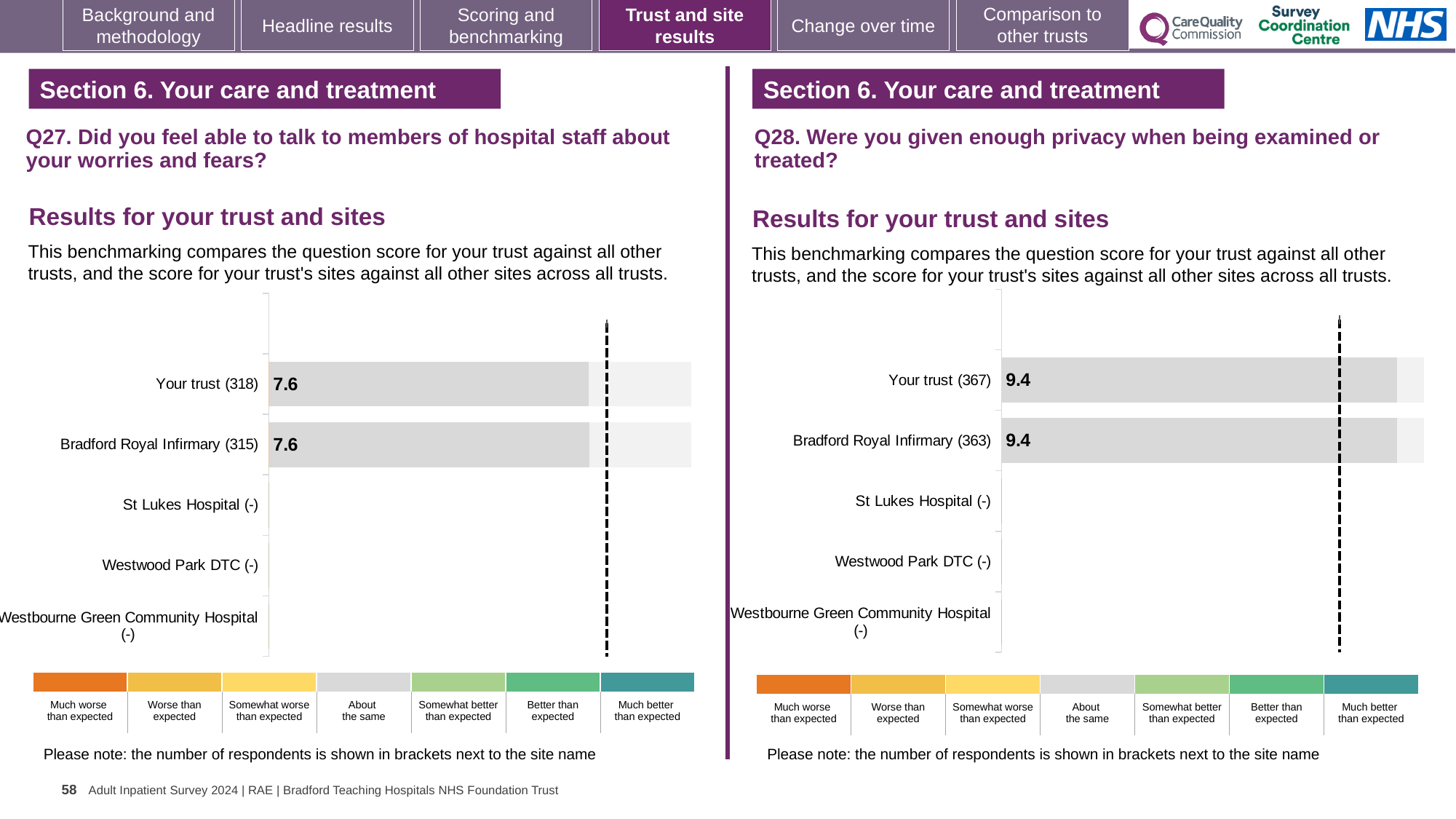
What kind of chart is the Q28 chart (right)? Bar chart How many site/trust categories are listed on the Q27 chart (left)? 5 Which is larger: the Your trust score on the Q27 chart (left) or the Your trust score on the Q28 chart (right)? Q28 chart (right) What is the difference between the Your trust score on the Q28 chart (right) and the Your trust score on the Q27 chart (left)? 1.8 On the Q27 chart (left), how many sites show no score (marked with a dash)? 3 On the Q27 chart (left), what is the score for Your trust? 7.6 On the Q28 chart (right), what is the score for Your trust? 9.4 On the Q28 chart (right), what is the score for Bradford Royal Infirmary? 9.4 On the Q27 chart (left), what is the score for Bradford Royal Infirmary? 7.6 How many colour categories are shown in the legend below the Q28 chart (right)? 7 On the Q27 chart (left), how many respondents are shown in brackets for Your trust? 318 On the Q28 chart (right), how many respondents are shown in brackets for Bradford Royal Infirmary? 363